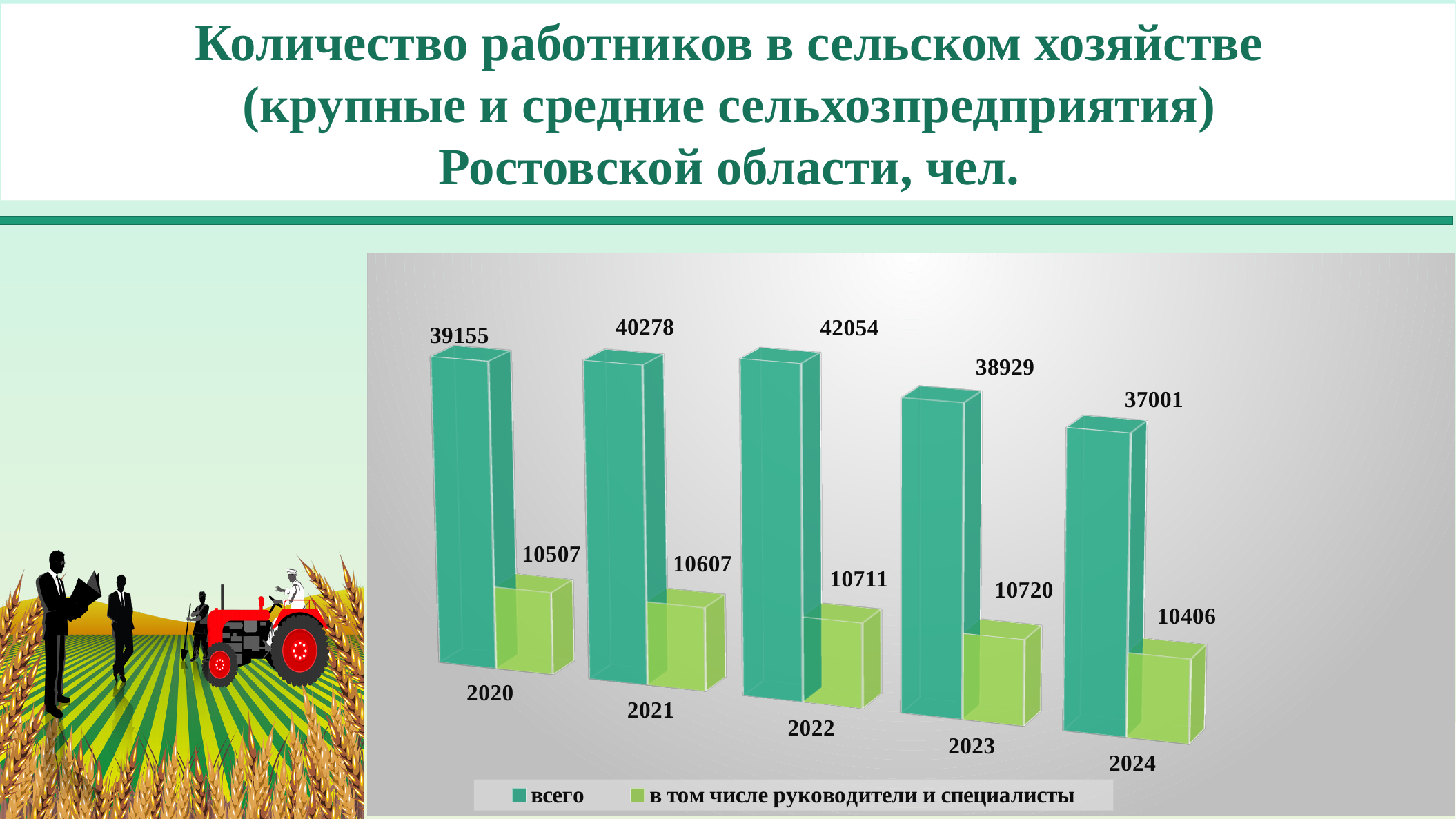
What is the difference between the "всего" values for 2022 and 2024? 5053 Which year has the lowest value for "всего"? 2024 What kind of chart is shown on the slide? bar chart What is the value of "всего" for 2022? 42054 Which year has the highest value for "в том числе руководители и специалисты"? 2023 How many years are shown on the x axis? 5 Which is larger: the "всего" value for 2021 or for 2023? 2021 What is the value of "в том числе руководители и специалисты" for 2024? 10406 What is the difference between "всего" and "в том числе руководители и специалисты" in 2021? 29671 What is the value of "всего" for 2020? 39155 Which year has the highest value for "всего"? 2022 How many series does the legend list? 2